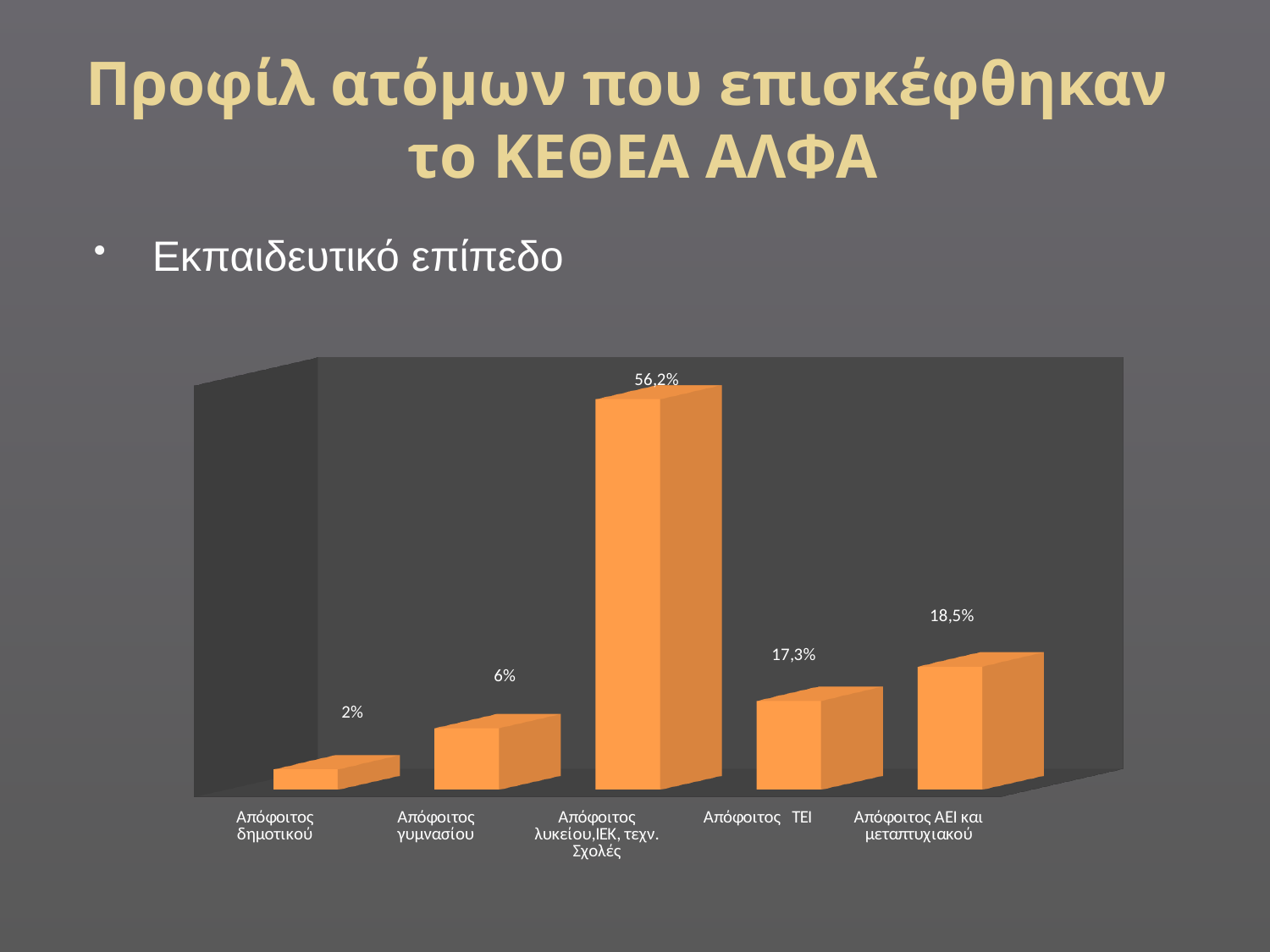
What is the difference between the value for Απόφοιτος λυκείου, ΙΕΚ, τεχν. Σχολές and the value for Απόφοιτος ΑΕΙ και μεταπτυχιακού? 37,7% Which category has the lowest value? Απόφοιτος δημοτικού What topic does the bullet point above the chart say the chart is about? Εκπαιδευτικό επίπεδο What is the value for Απόφοιτος γυμνασίου? 6% How many categories does the chart show? 5 What is the value for Απόφοιτος ΑΕΙ και μεταπτυχιακού? 18,5% What is the value for Απόφοιτος λυκείου, ΙΕΚ, τεχν. Σχολές? 56,2% What is the value for Απόφοιτος δημοτικού? 2% Which is larger, the value for Απόφοιτος ΤΕΙ or the value for Απόφοιτος ΑΕΙ και μεταπτυχιακού? Απόφοιτος ΑΕΙ και μεταπτυχιακού What is the value for Απόφοιτος ΤΕΙ? 17,3% Which category has the highest value? Απόφοιτος λυκείου, ΙΕΚ, τεχν. Σχολές What kind of chart is shown on the slide? Bar chart